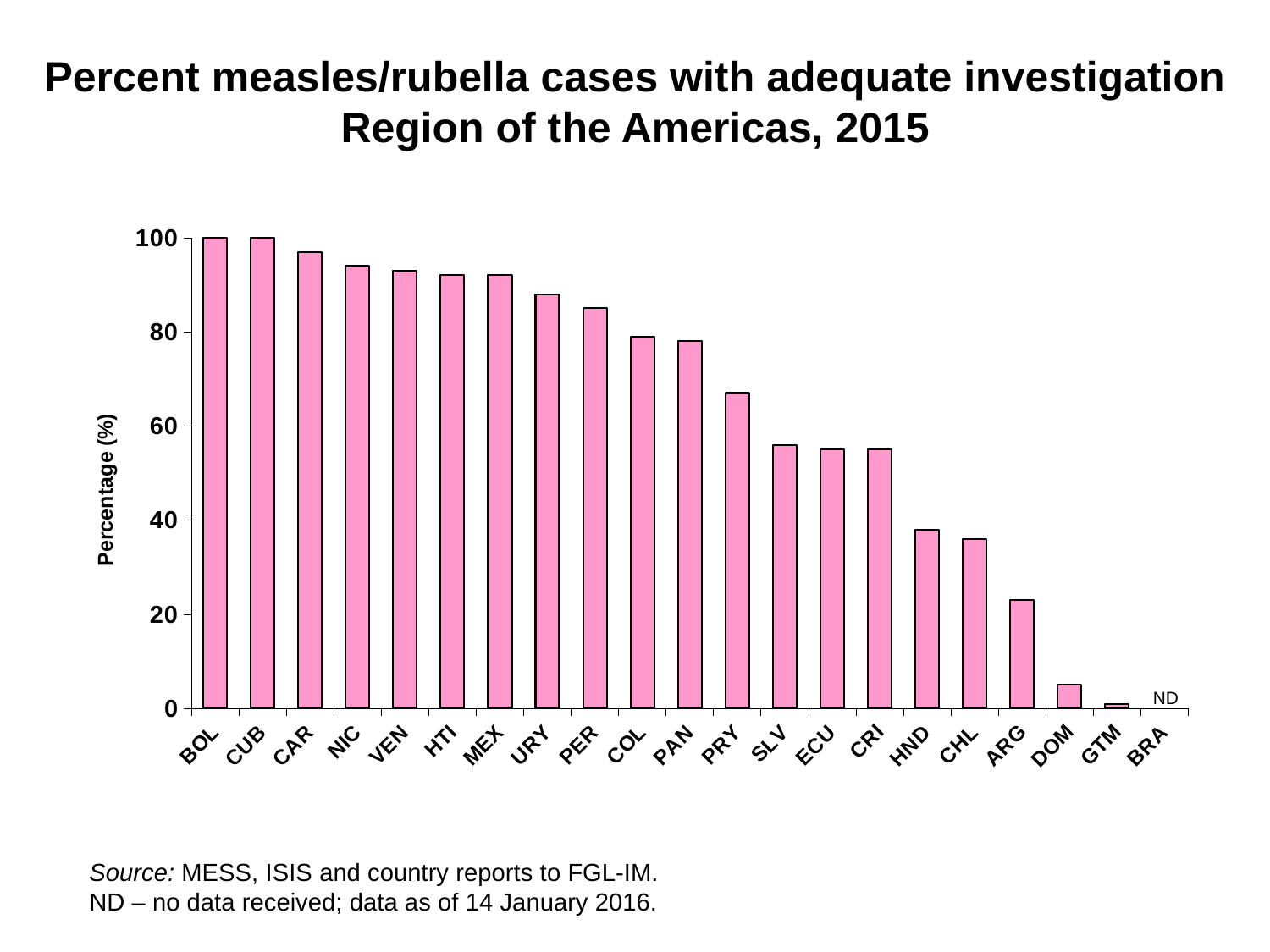
Do the values rise or fall moving from left to right along the x axis? fall Is the value for ARG greater or less than 20? greater What kind of chart is shown on the slide? bar chart Is the value for PRY greater or less than 60? greater Is the value for URY greater or less than 80? greater How many countries are listed along the x axis of the chart? 21 Which country is marked ND (no data received) on the chart? BRA Which has the larger value, PER or PRY? PER Which country has the lowest plotted bar? GTM What is the value for CUB? 100 What is the value for BOL? 100